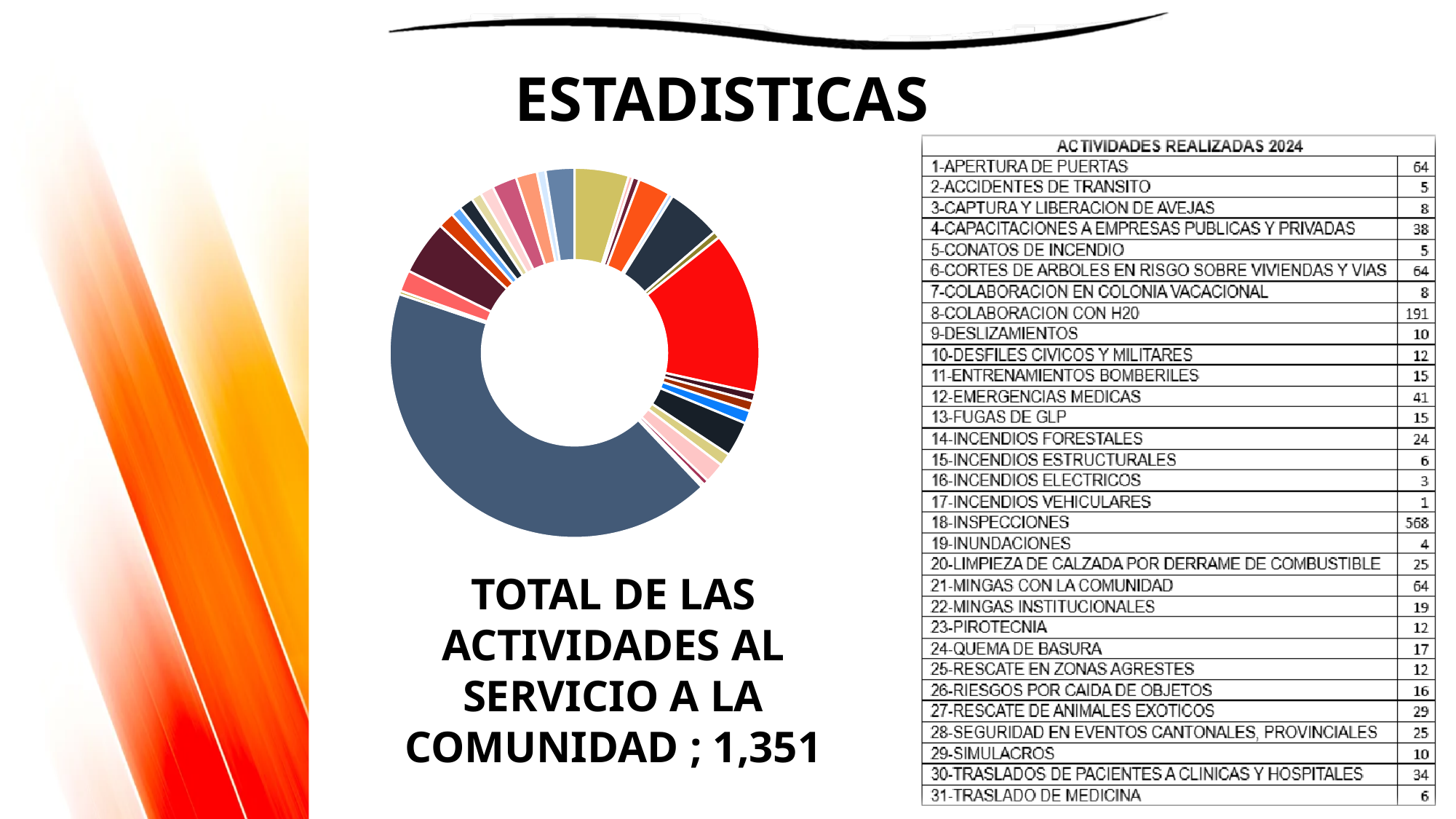
What is the difference between the values for INSPECCIONES and COLABORACION CON H20? 377 What is the difference between the values for APERTURA DE PUERTAS and CAPACITACIONES A EMPRESAS PUBLICAS Y PRIVADAS? 26 What is the title of the data table accompanying the donut chart? ACTIVIDADES REALIZADAS 2024 How many activities were recorded for EMERGENCIAS MEDICAS? 41 Which activity has the smallest value in the 2024 activities data? 17-INCENDIOS VEHICULARES What kind of chart is shown on the slide? Pie (donut) chart Which is larger, the value for INSPECCIONES or the value for COLABORACION CON H20? INSPECCIONES How many activities were recorded for INSPECCIONES in 2024? 568 What is the total of all activities shown on the slide? 1,351 How many activity categories are plotted in the donut chart? 30 Which activity accounts for the largest slice of the donut chart? 18-INSPECCIONES How many activities were recorded for COLABORACION CON H20? 191